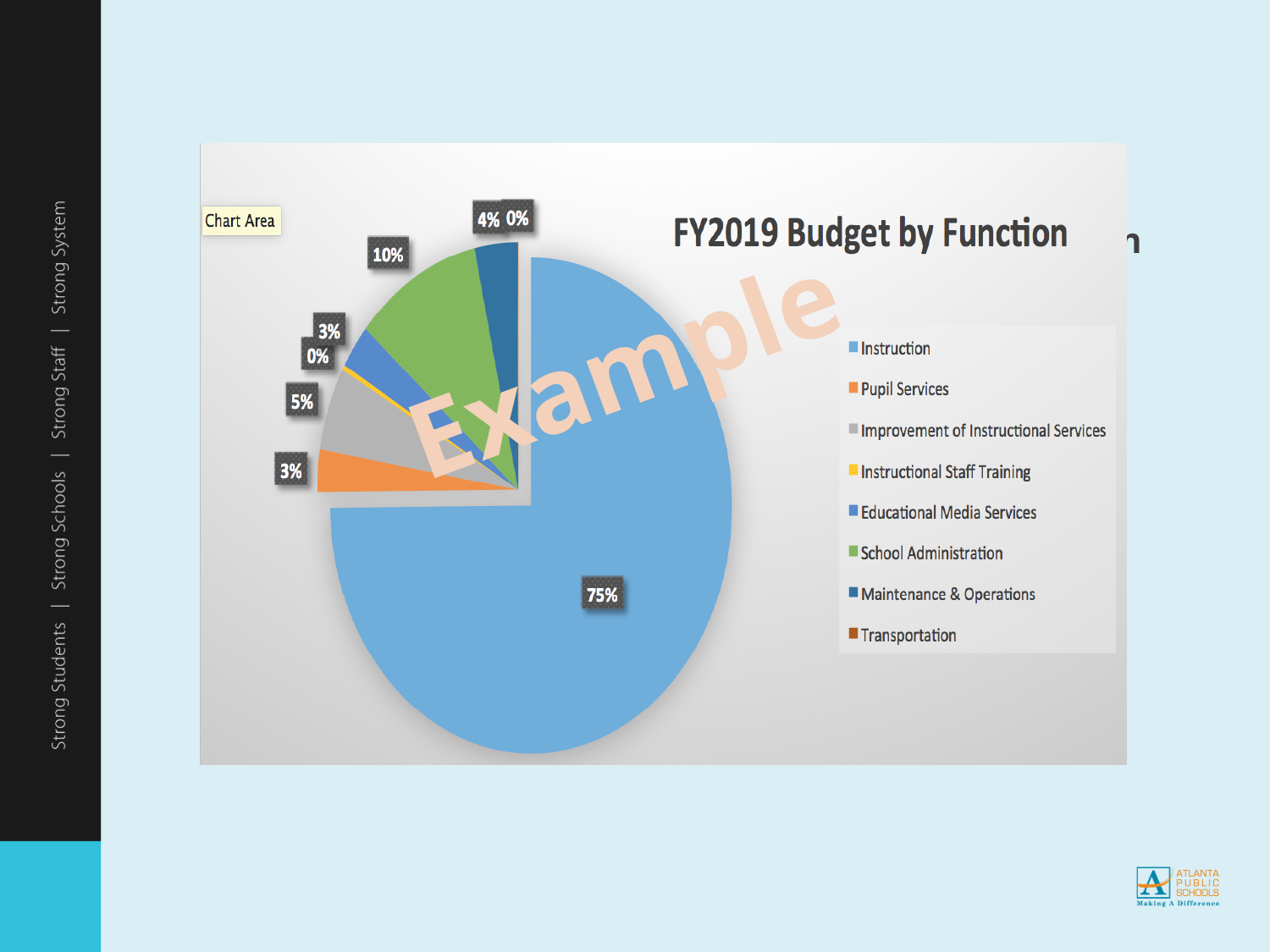
What share of the FY2019 budget goes to School Administration? 10% What colour is the Instruction slice in the pie chart? light blue What share of the FY2019 budget goes to Pupil Services? 3% What is the title of the chart? FY2019 Budget by Function What share of the FY2019 budget goes to Improvement of Instructional Services? 5% What share of the FY2019 budget goes to Maintenance & Operations? 4% What kind of chart is shown on the slide? pie chart What is the difference between the Instruction share and the School Administration share? 65% How many categories does the legend of the pie chart list? 8 Which is larger, the share for School Administration or the share for Maintenance & Operations? School Administration What share of the FY2019 budget goes to Instruction? 75% Which function has the largest share of the FY2019 budget? Instruction